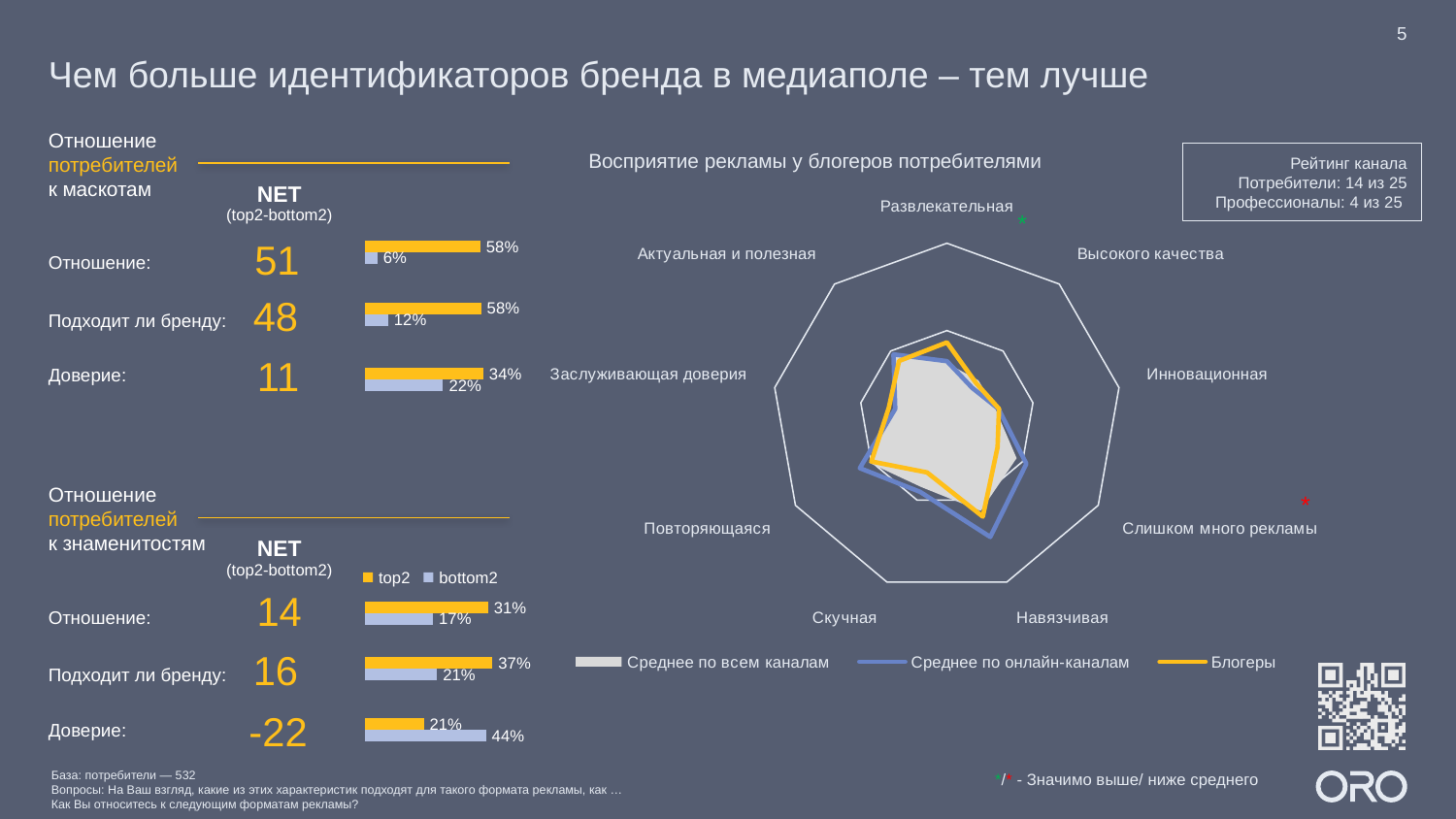
In the chart 'Восприятие рекламы у блогеров потребителями', which series is drawn in yellow? Блогеры In the bar chart for attitude of consumers to mascots (top left), what is the bottom2 value for 'Доверие'? 22% What type of chart is 'Восприятие рекламы у блогеров потребителями'? Radar chart In the bar chart for attitude of consumers to celebrities (bottom left), which is larger for 'Доверие': top2 or bottom2? bottom2 How many series does the legend of the bar charts on the left list? 2 How many categories (axes) does the chart 'Восприятие рекламы у блогеров потребителями' have? 9 In the bar chart for attitude of consumers to mascots (top left), what is the difference between the top2 and bottom2 values for 'Подходит ли бренду'? 46% In the bar chart for attitude of consumers to celebrities (bottom left), which category has the highest top2 value? Подходит ли бренду In the bar chart for attitude of consumers to celebrities (bottom left), what is the difference between the bottom2 and top2 values for 'Доверие'? 23% In the bar chart for attitude of consumers to celebrities (bottom left), what is the bottom2 value for 'Доверие'? 44% In the bar chart for attitude of consumers to mascots (top left), what is the top2 value for 'Отношение'? 58% How many series does the legend of the chart 'Восприятие рекламы у блогеров потребителями' list? 3